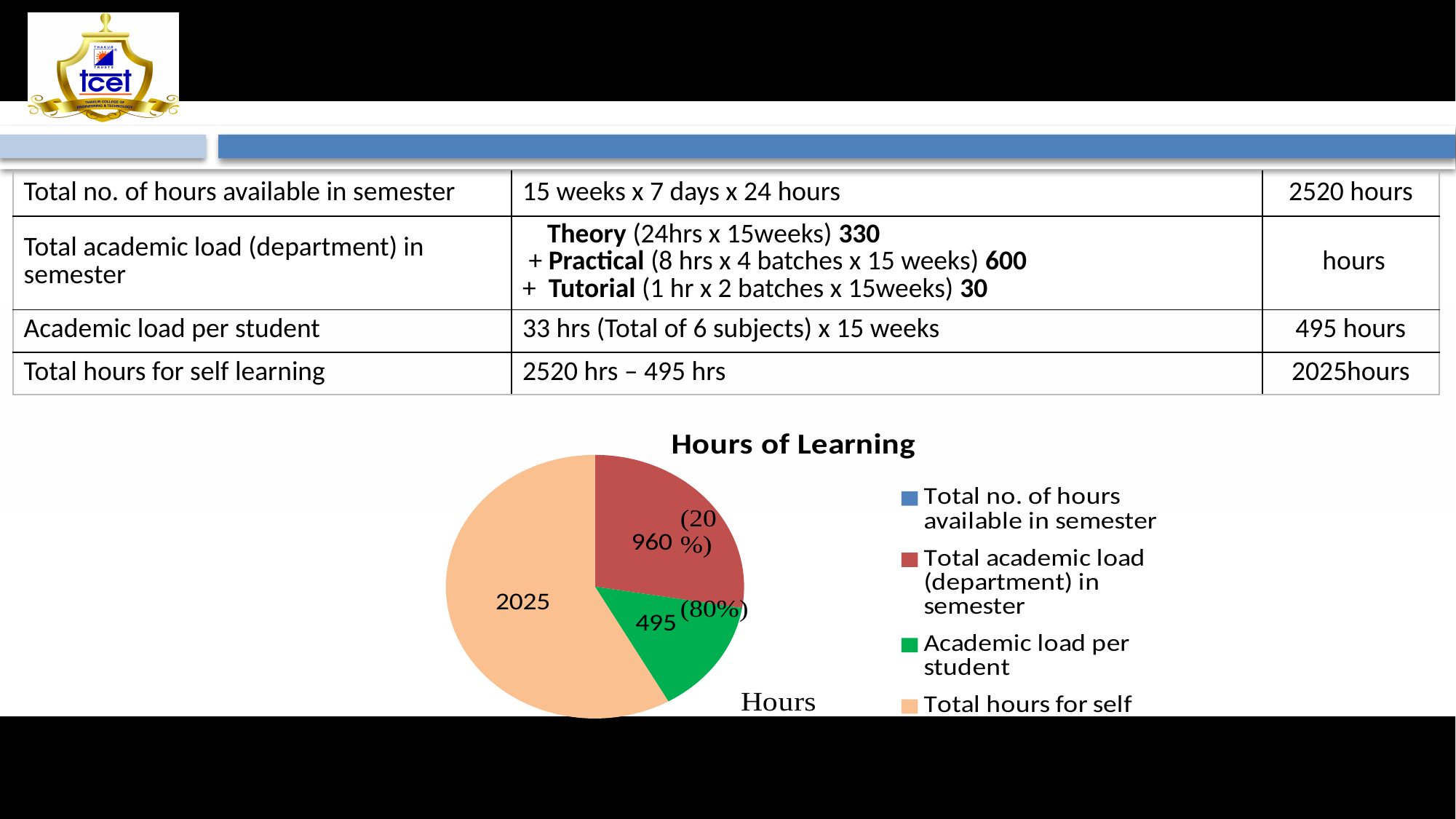
What colour is the slice for Academic load per student in the Hours of Learning pie chart? green What is the title of the chart on the slide? Hours of Learning Which slice of the Hours of Learning pie chart is the largest? Total hours for self learning In the Hours of Learning pie chart, what value is shown for Total hours for self learning? 2025 In the Hours of Learning pie chart, what is the difference between Total academic load (department) in semester and Academic load per student? 465 In the Hours of Learning pie chart, what value is shown for Total academic load (department) in semester? 960 Which slice of the Hours of Learning pie chart is the smallest? Academic load per student In the Hours of Learning pie chart, what value is shown for Academic load per student? 495 In the Hours of Learning pie chart, what is the difference between Total hours for self learning and Academic load per student? 1530 What kind of chart is shown under the title "Hours of Learning"? pie chart In the Hours of Learning pie chart, which is larger: Total academic load (department) in semester or Academic load per student? Total academic load (department) in semester How many entries does the legend of the Hours of Learning pie chart list? 4